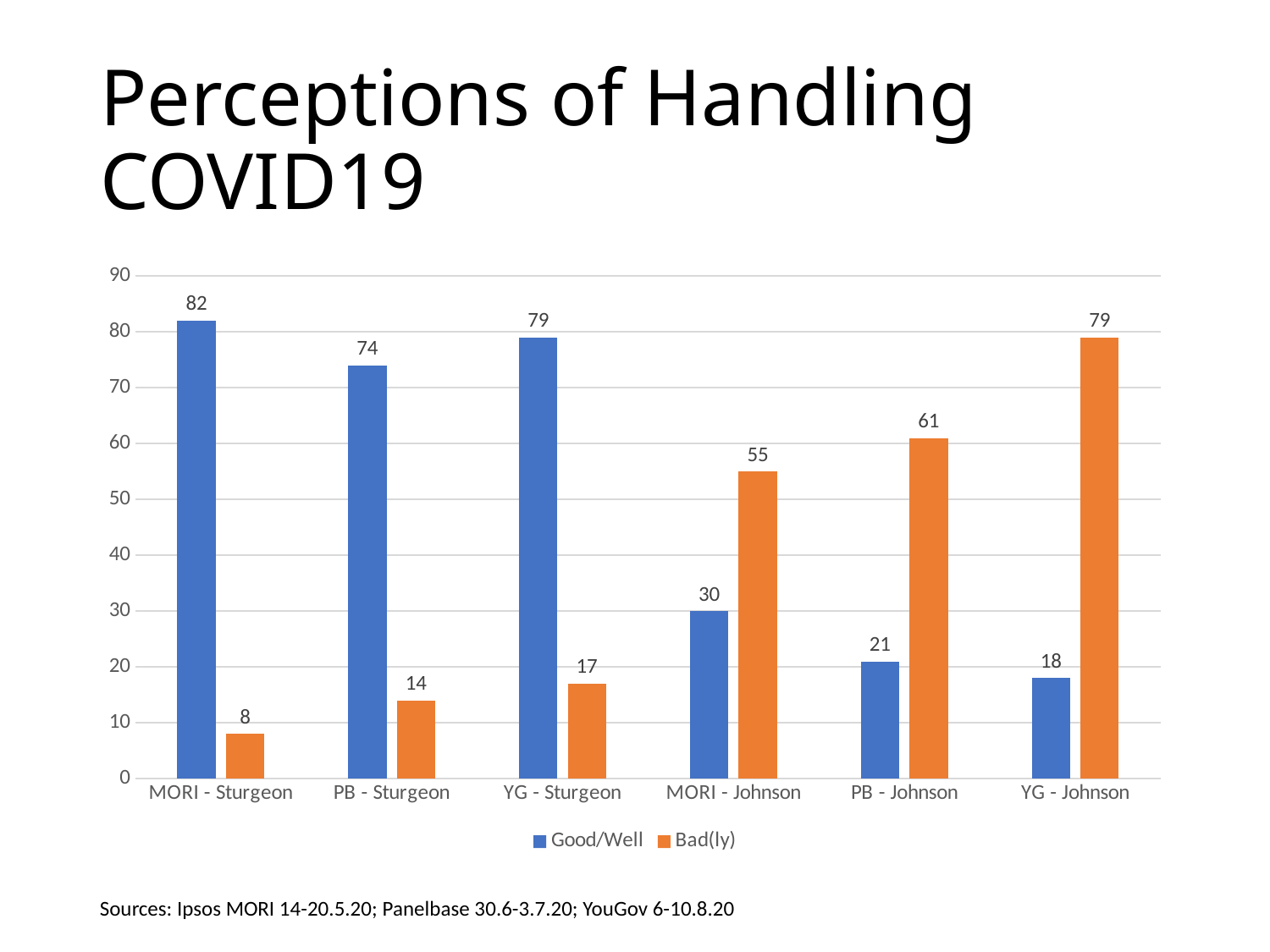
How many categories are shown on the x axis? 6 What is the difference between the Good/Well and Bad(ly) values for YG - Sturgeon? 62 What kind of chart is shown on the slide? Bar chart What is the Bad(ly) value for PB - Johnson? 61 What is the Good/Well value for MORI - Sturgeon? 82 How many series does the legend list? 2 What is the Good/Well value for YG - Johnson? 18 Is the Bad(ly) value for YG - Johnson greater or less than 70? greater Which is larger for MORI - Johnson: the Good/Well value or the Bad(ly) value? Bad(ly) Which category has the lowest Bad(ly) value? MORI - Sturgeon Which category has the highest Good/Well value? MORI - Sturgeon What colour are the Bad(ly) bars? Orange